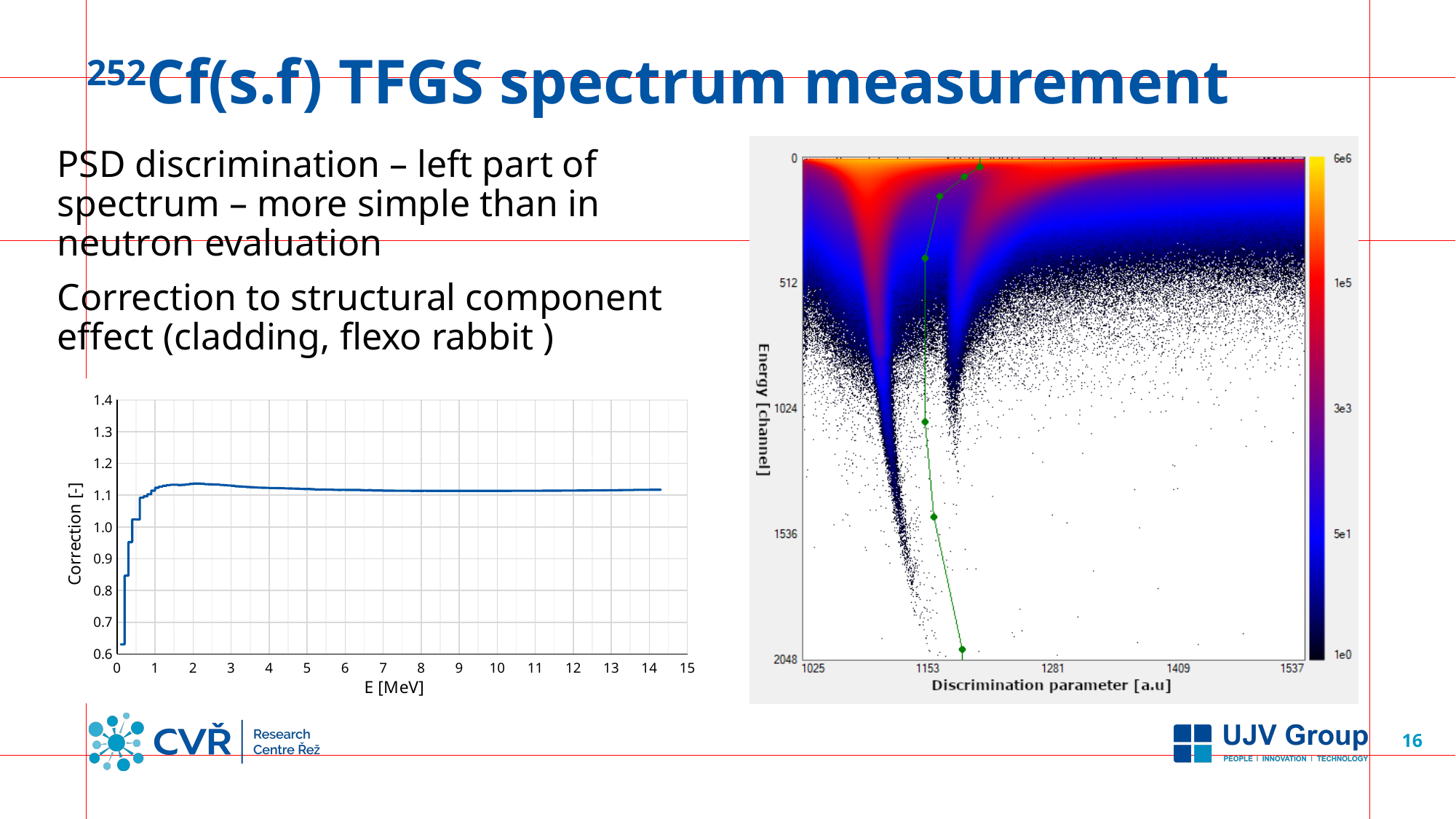
In the right chart (PSD discrimination plot), what is the highest value shown on the colour scale? 6e6 In the left chart, is the correction value at E = 10 MeV greater or less than 1.2? less In the left chart, is the correction value at the lowest plotted energy (near E = 0) greater or less than 0.7? less In the left chart, what is the label of the y axis? Correction [-] What kind of chart is the chart on the left of the slide (Correction vs E [MeV])? line chart In the right chart (PSD discrimination plot), what is the label of the x axis? Discrimination parameter [a.u] In the left chart, does the correction rise or fall as E increases from 0 to 1 MeV? rise In the left chart, which is larger: the correction at E = 2 MeV or at E = 0.5 MeV? E = 2 MeV In the left chart, is the correction value at E = 5 MeV greater or less than 1.0? greater